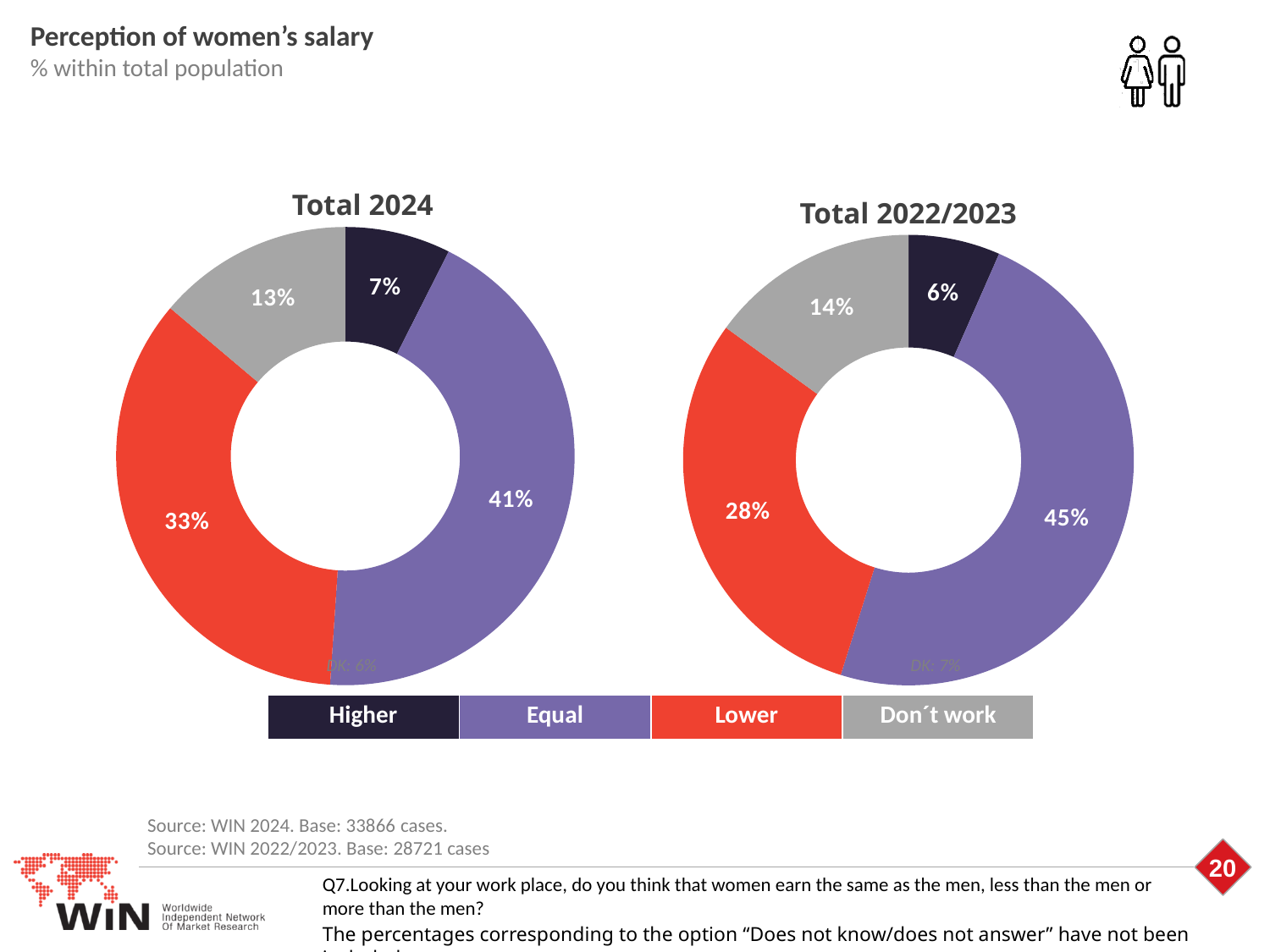
In the Total 2024 chart, what percentage is shown for Lower? 33% In the Total 2022/2023 chart, what percentage is shown for Don't work? 14% Which colour represents the Lower category in the legend? Red How many categories does the legend list for the charts? 4 Is the Lower share larger in the Total 2024 chart or in the Total 2022/2023 chart? Total 2024 In the Total 2024 chart, which category has the largest share? Equal In the Total 2022/2023 chart, what percentage is shown for Higher? 6% What is the difference between the Equal share in the Total 2022/2023 chart and the Equal share in the Total 2024 chart? 4% What type of chart is the Total 2024 chart? Donut (pie) chart In the Total 2024 chart, what is the combined share of Higher and Lower? 40% In the Total 2024 chart, what percentage is shown for Equal? 41% In the Total 2022/2023 chart, which category has the smallest share? Higher